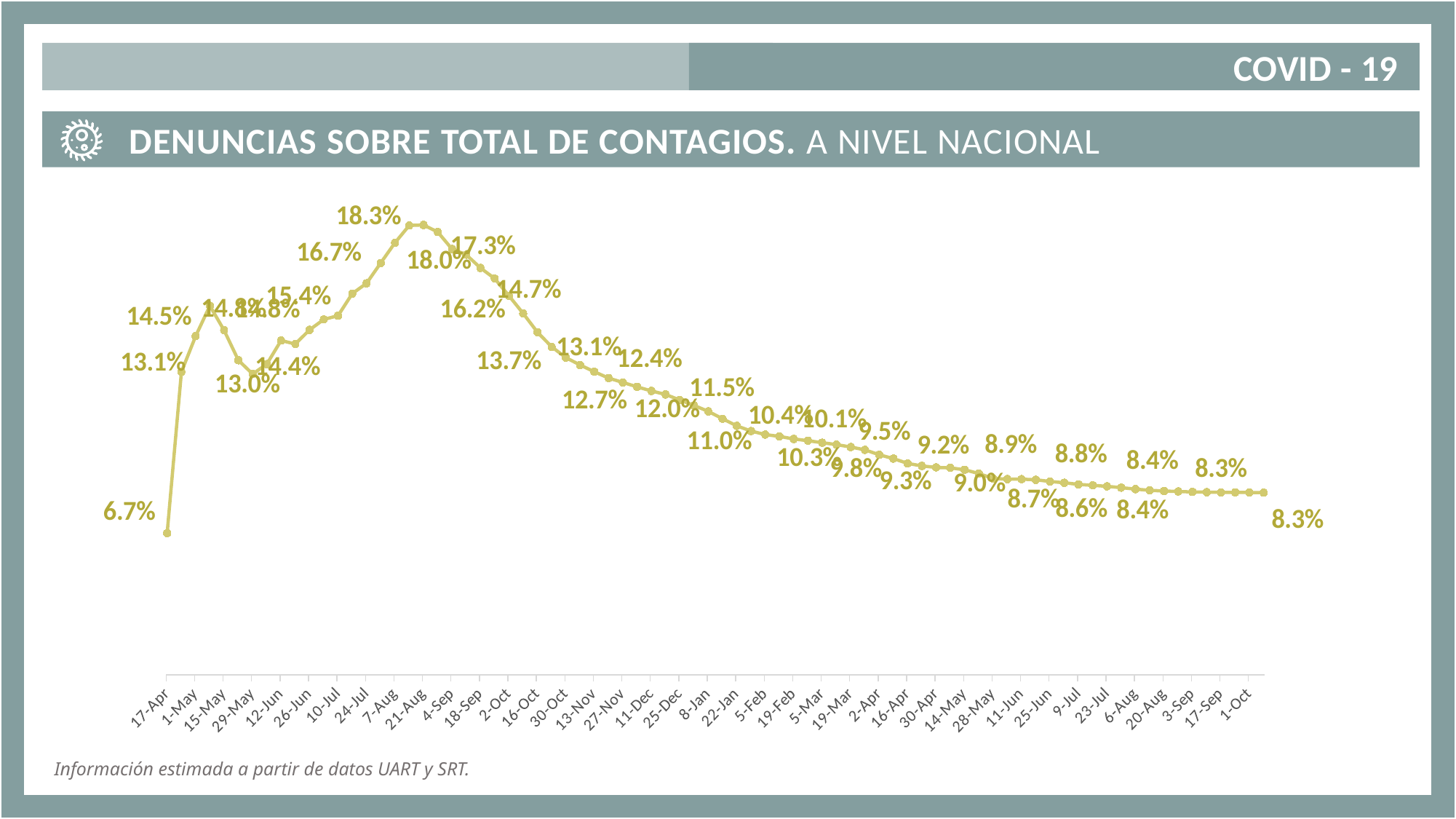
Do the values rise or fall from the peak in August through to 1-Oct? fall What is the title of the chart? DENUNCIAS SOBRE TOTAL DE CONTAGIOS. A NIVEL NACIONAL What kind of chart is shown on the slide? line chart What is the value for 1-Oct, the last point on the line? 8.3% What is the difference between the peak value of 18.3% and the final value of 8.3%? 10.0 percentage points Which is larger, the value for 17-Apr or the value for 1-Oct? 1-Oct What is the value for 17-Apr, the first point on the line? 6.7% What is the value for 1-May? 14.5% How many date labels are shown on the x axis? 39 What is the difference between the highest value (18.3%) and the first value (6.7%)? 11.6 percentage points What is the lowest value shown on the line? 6.7%